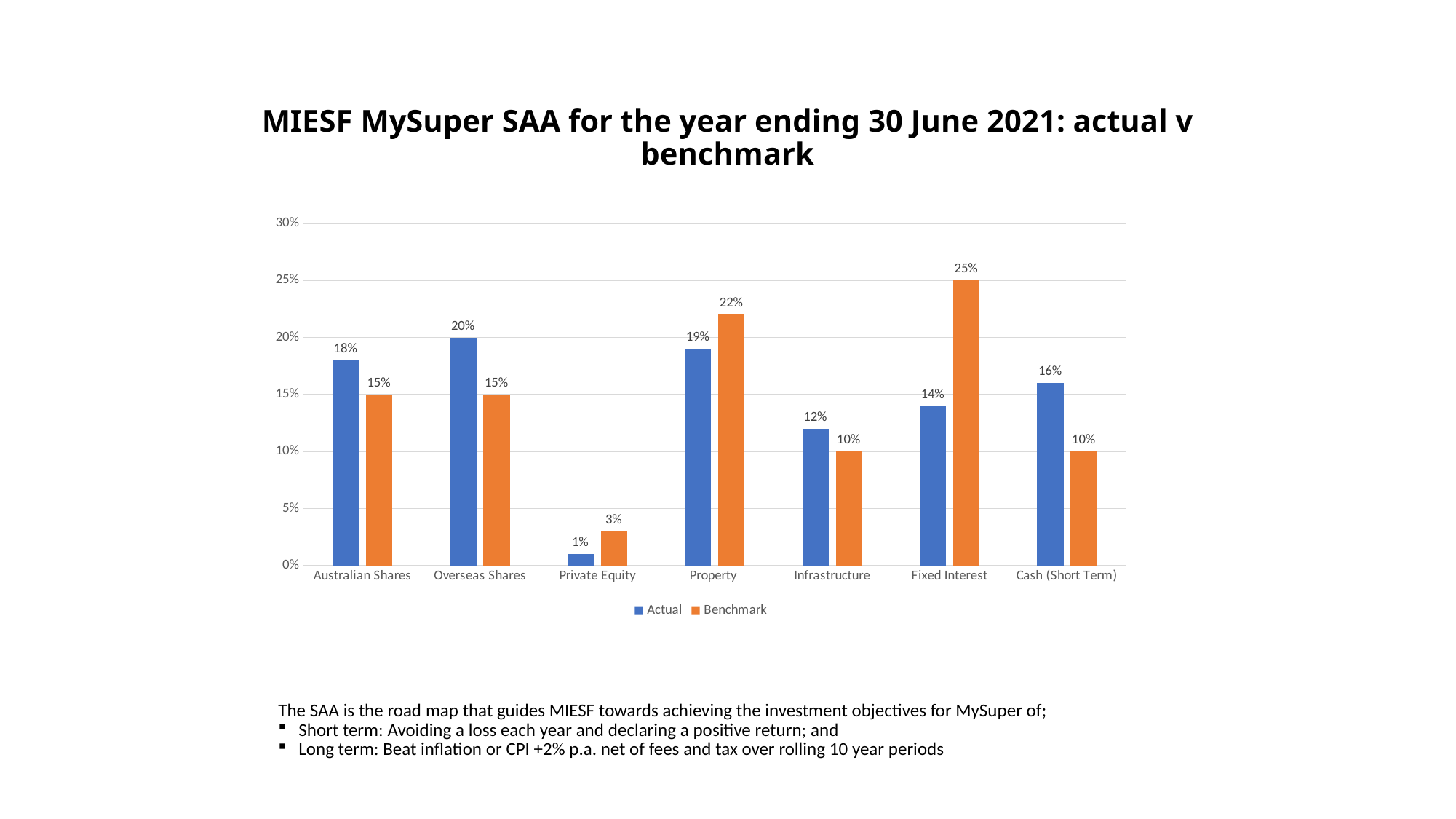
What is the Actual value for Australian Shares? 18% What kind of chart is shown on the slide? Bar chart What colour are the Benchmark bars? Orange Which category has the highest Benchmark value? Fixed Interest Is the Actual value for Cash (Short Term) greater or less than 15%? greater How many asset categories are shown on the x axis? 7 How many series does the legend list? 2 What is the Actual value for Private Equity? 1% Which is larger for Property, the Actual value or the Benchmark value? Benchmark What is the Benchmark value for Fixed Interest? 25% What is the difference between the Benchmark and Actual values for Fixed Interest? 11% Which category has the lowest Actual value? Private Equity